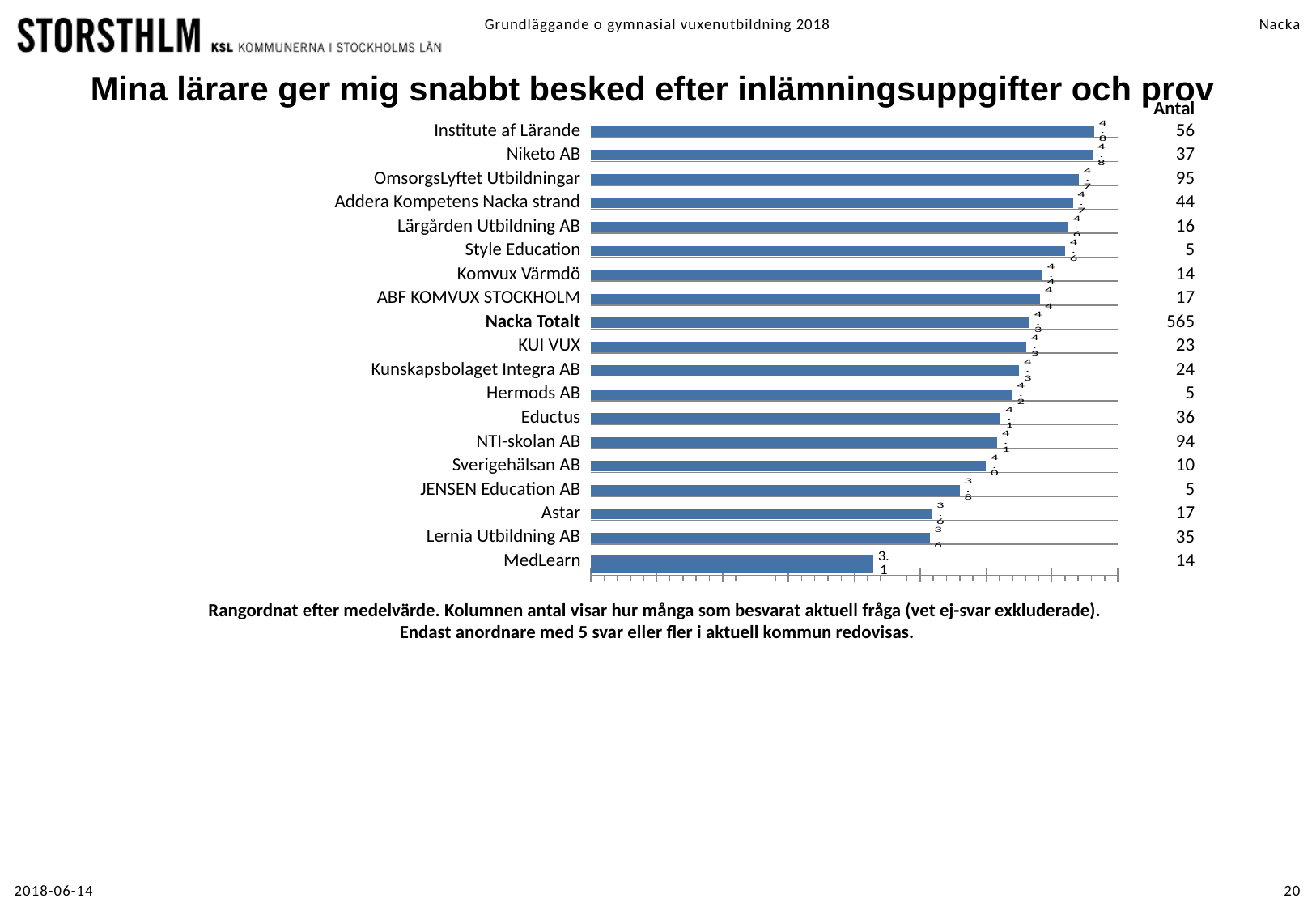
How many providers (bars) are shown in the chart? 19 What is the difference between the values for Institute af Lärande and MedLearn? 1.7 What is the value shown for Hermods AB? 4.2 What kind of chart is shown on the slide? bar chart What is the value shown for MedLearn? 3.1 Do the bar values rise or fall going from the top of the chart to the bottom? fall Which provider has the lowest value in the chart? MedLearn What is the value shown for JENSEN Education AB? 3.8 What is the value shown for Nacka Totalt? 4.3 According to the Antal column, how many respondents answered for Nacka Totalt? 565 Which has a larger value, OmsorgsLyftet Utbildningar or Hermods AB? OmsorgsLyftet Utbildningar What is the title of the chart? Mina lärare ger mig snabbt besked efter inlämningsuppgifter och prov